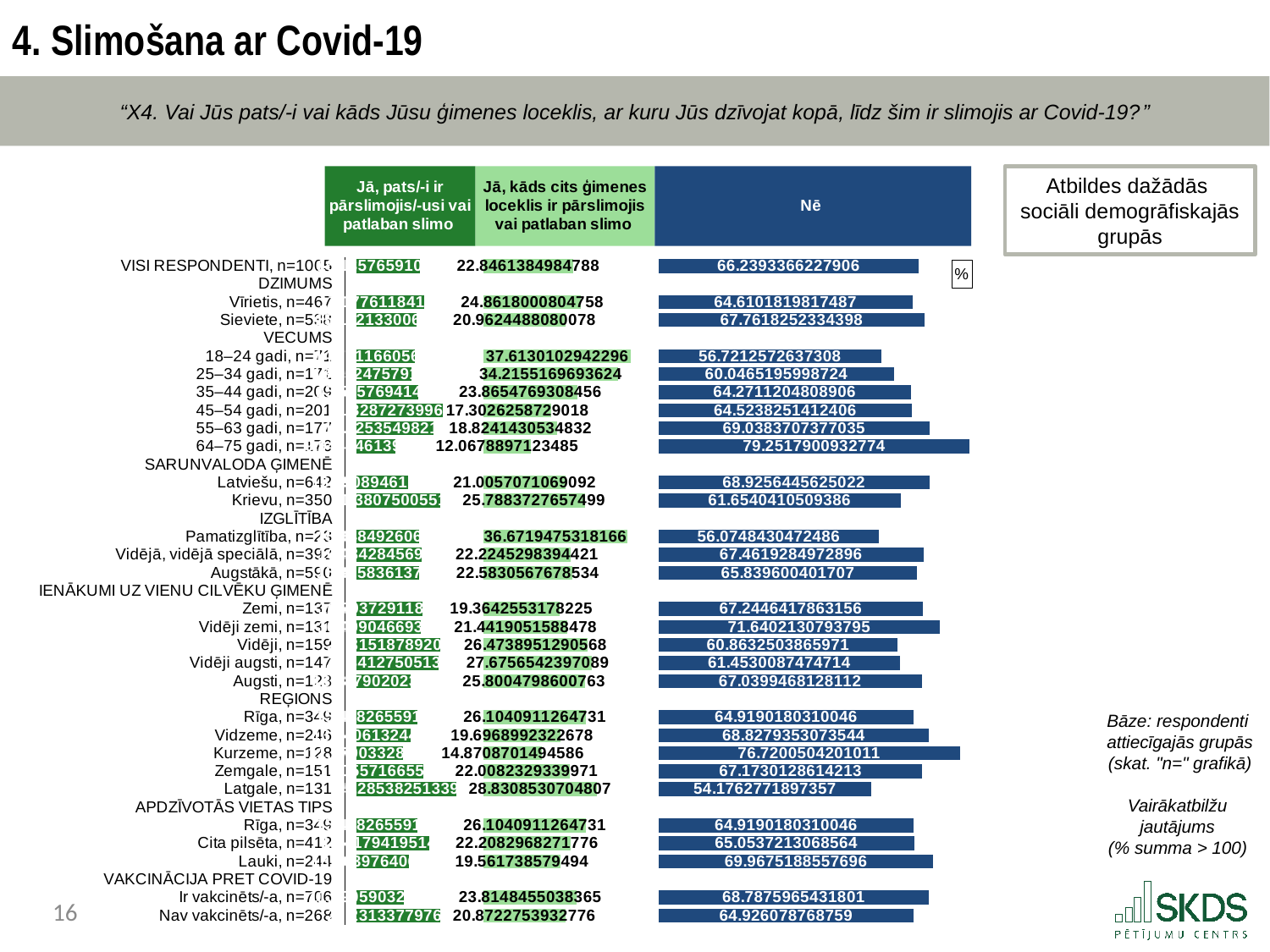
What is the "Nē" value for VISI RESPONDENTI, n=1005? 66.2393366227906 What is the value of "Jā, kāds cits ģimenes loceklis ir pārslimojis vai patlaban slimo" for the 18–24 gadi group? 37.6130102942296 How many series does the chart legend list? 3 What is the "Nē" value for Latgale, n=131? 54.1762771897357 Which has the larger "Nē" value, Vīrietis or Sieviete? Sieviete Which category has the lowest "Nē" value on the chart? Latgale, n=131 What kind of chart is shown on the slide? Stacked horizontal bar chart What is the "Nē" value for the 64–75 gadi age group? 79.2517900932774 Among the REĢIONS categories, which has the highest "Nē" value? Kurzeme, n=128 What is the difference between the "Nē" values for Kurzeme and Latgale? 22.5437732303654 Which category has the highest "Nē" value on the chart? 64–75 gadi, n=176 Which colour represents the "Nē" series in the chart? Dark blue